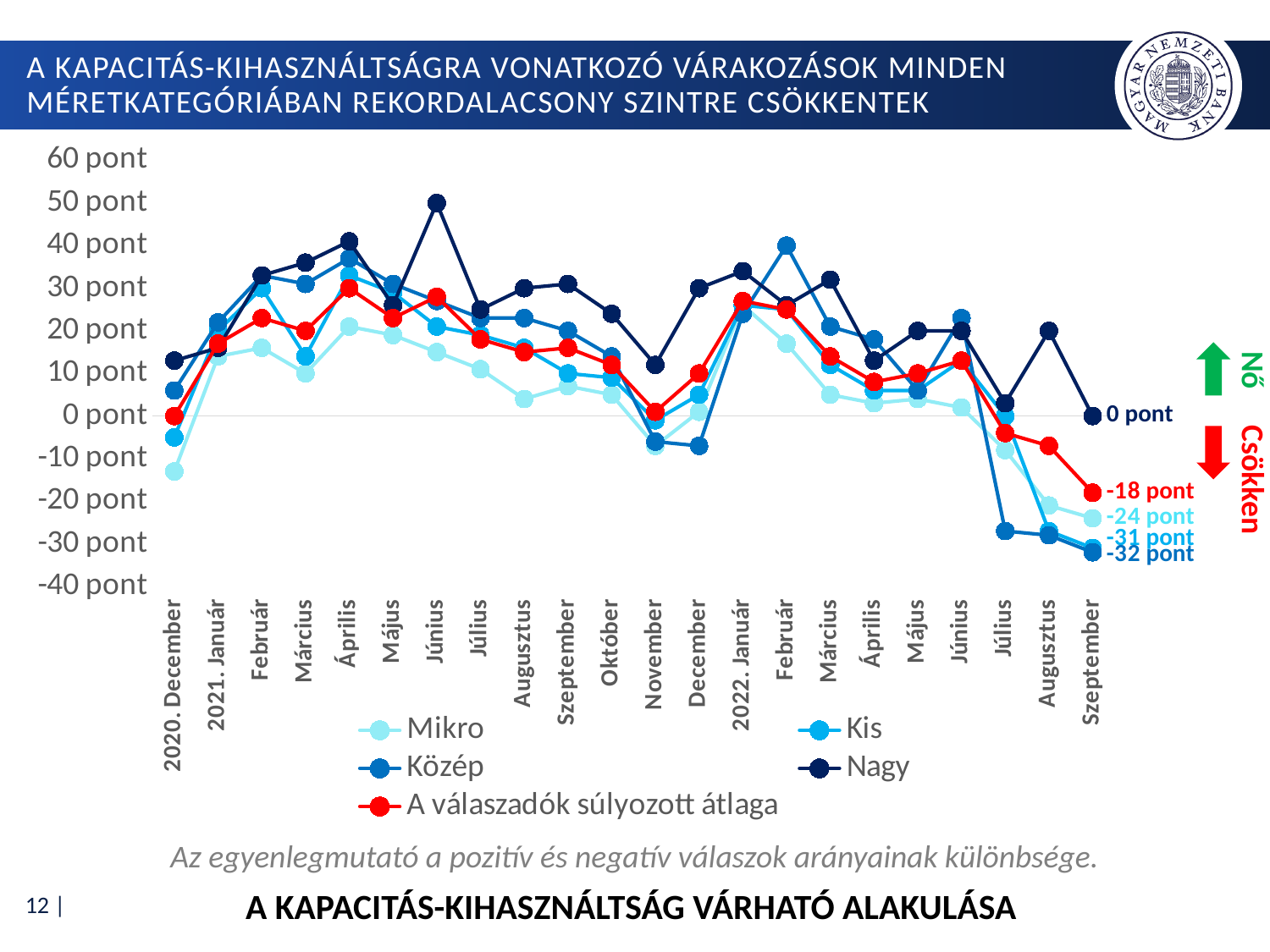
Which series has the highest value at 2022 Szeptember? Nagy What is the lowest labelled value at 2022 Szeptember? -32 pont In 2021 Június, which series has the larger value, Nagy or Mikro? Nagy How many series does the legend list? 5 What is the value of the Nagy series at the last point (2022 Szeptember)? 0 pont Is the value of the Nagy series in 2021 Június greater or less than 40 pont? greater What is the value of 'A válaszadók súlyozott átlaga' at 2022 Szeptember? -18 pont What is the difference between the Nagy value and the weighted average ('A válaszadók súlyozott átlaga') at 2022 Szeptember? 18 pont Is the value of the Mikro series in 2020 December greater or less than -10 pont? less What is the value of the Mikro series at 2022 Szeptember? -24 pont How many time points are shown on the x axis? 22 What kind of chart is shown on the slide? line chart